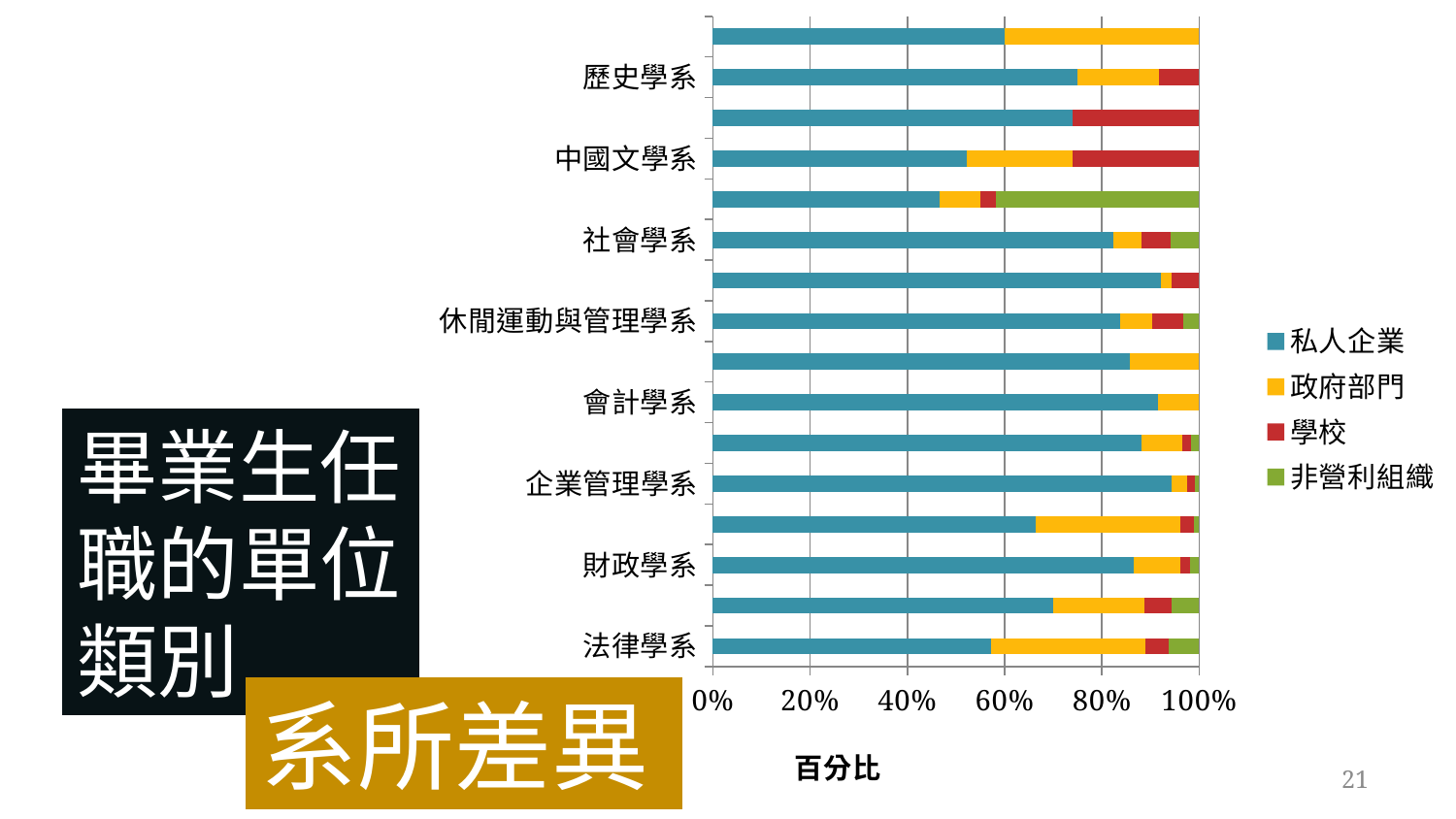
What kind of chart is shown on the slide? stacked bar chart Is the 私人企業 share for 歷史學系 greater or less than 60%? greater How many series does the legend list? 4 Which has a larger 私人企業 share, 法律學系 or 企業管理學系? 企業管理學系 How many bars are plotted in the chart? 16 Is the 私人企業 share for 會計學系 greater or less than 80%? greater Is the 私人企業 share for 中國文學系 greater or less than 60%? less What is the title of the horizontal axis? 百分比 Which has a larger 私人企業 share, 會計學系 or 中國文學系? 會計學系 What are the four series listed in the legend? 私人企業, 政府部門, 學校, 非營利組織